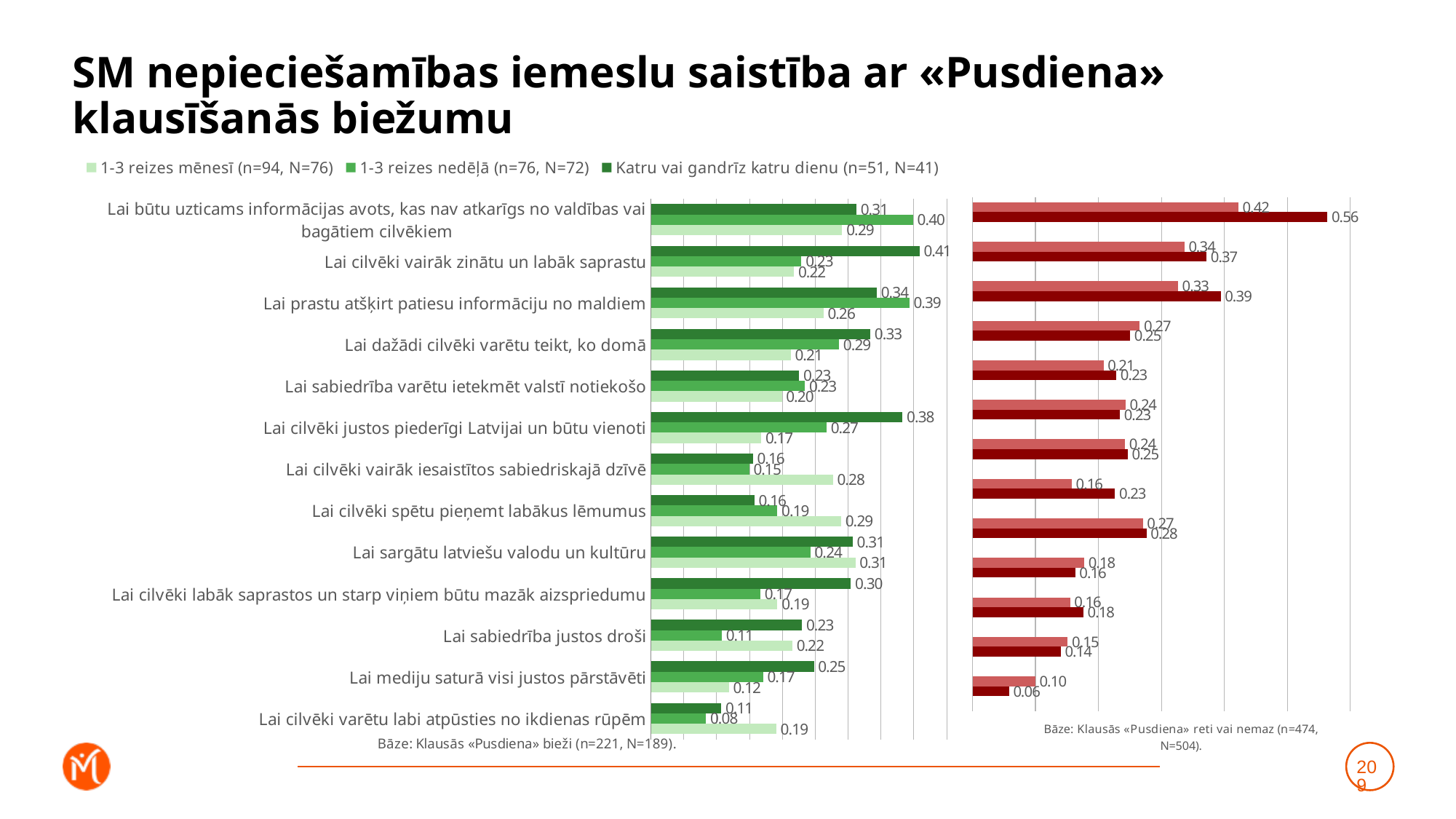
In the left (green) chart, for 'Lai cilvēki justos piederīgi Latvijai un būtu vienoti', which series has the larger value: 'Katru vai gandrīz katru dienu' or '1-3 reizes mēnesī'? Katru vai gandrīz katru dienu In the left (green) chart, for 'Lai būtu uzticams informācijas avots, kas nav atkarīgs no valdības vai bagātiem cilvēkiem', how much larger is the '1-3 reizes nedēļā' value than the '1-3 reizes mēnesī' value? 0.11 How many series does the legend of the left (green) chart list? 3 In the left (green) chart, which legend entry corresponds to the darkest green bars? Katru vai gandrīz katru dienu (n=51, N=41) What kind of chart is the left (green) chart? Bar chart What is the lowest value shown in the right (red) chart? 0.06 In the left (green) chart, what is the value for '1-3 reizes mēnesī' for 'Lai cilvēki spētu pieņemt labākus lēmumus'? 0.29 What is the highest value shown in the right (red) chart? 0.56 How many categories are listed in the left (green) chart? 13 In the left (green) chart, which category has the lowest value for '1-3 reizes nedēļā'? Lai cilvēki varētu labi atpūsties no ikdienas rūpēm In the left (green) chart, which category has the highest value for 'Katru vai gandrīz katru dienu'? Lai cilvēki vairāk zinātu un labāk saprastu In the left (green) chart, what is the value for 'Katru vai gandrīz katru dienu' for 'Lai cilvēki vairāk zinātu un labāk saprastu'? 0.41